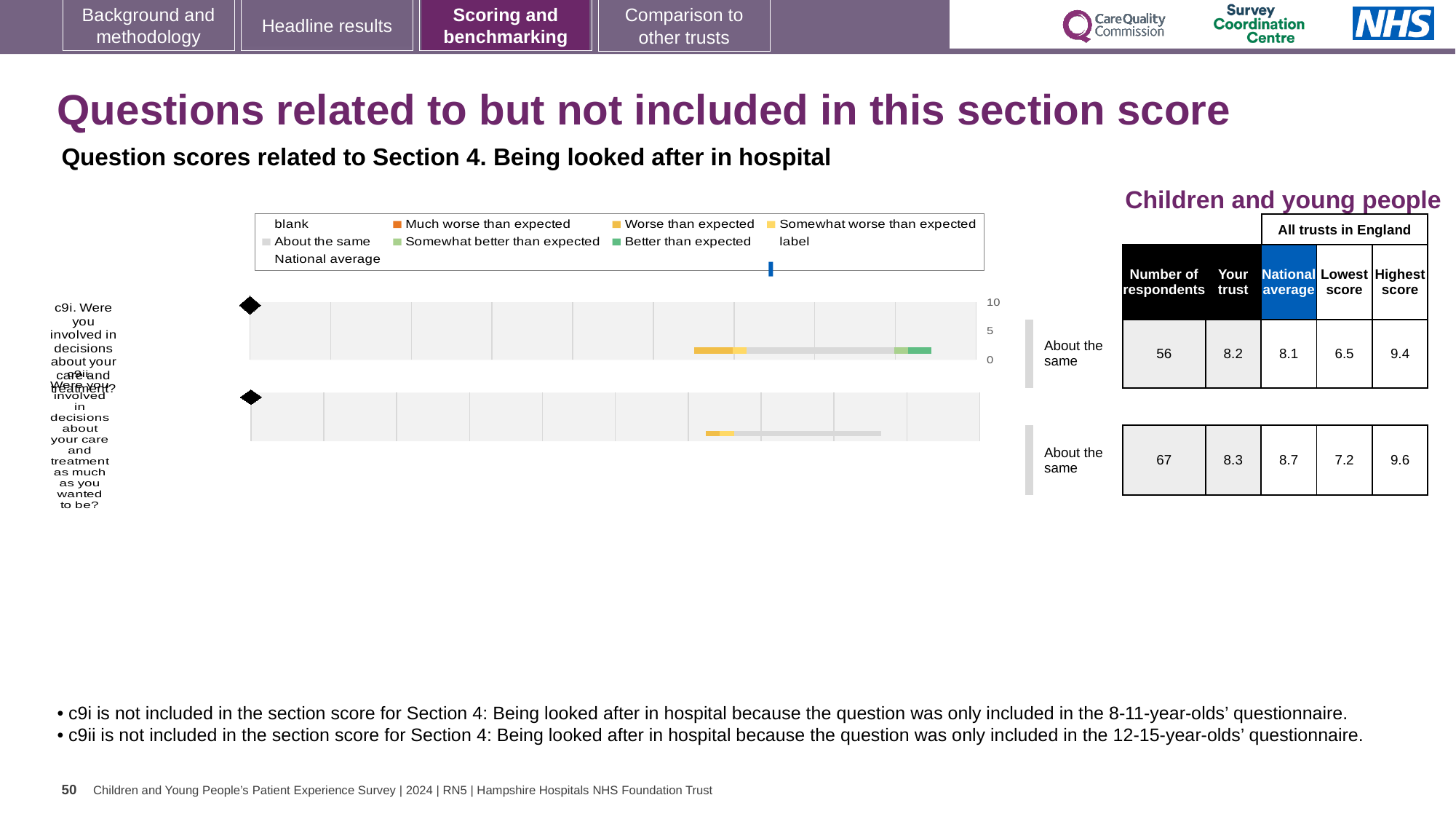
What is the benchmark result shown next to the bar for question c9ii? About the same What is the benchmark result shown next to the bar for question c9i? About the same In the table beside the chart, what is the 'Your trust' score for question c9i? 8.2 What kind of chart is used to show the question scores for c9i and c9ii? Bar chart In the table beside the chart, which question has the higher 'Your trust' score, c9i or c9ii? c9ii According to the legend, what colour represents 'Better than expected'? Green How many questions (categories) are plotted in the chart? 2 In the table beside the chart, what is the difference between the highest score and the lowest score for question c9i? 2.9 According to the legend, what colour represents 'Much worse than expected'? Orange In the table beside the chart, what is the national average score for question c9ii? 8.7 How many entries does the chart legend list? 9 In the table beside the chart, how many respondents answered question c9ii? 67